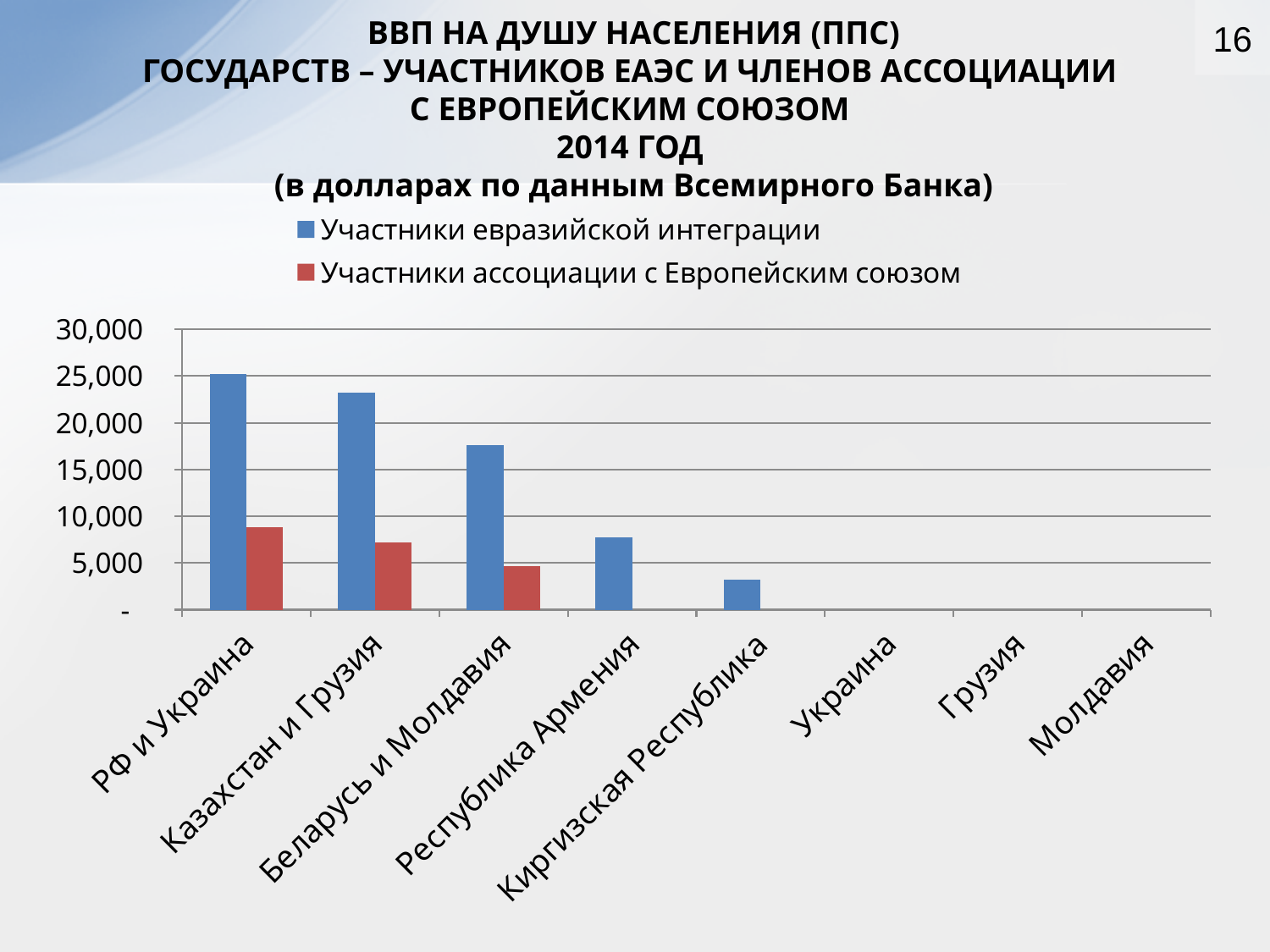
What kind of chart is shown on the slide? bar chart Which is larger in the category 'РФ и Украина': the value for 'Участники евразийской интеграции' or for 'Участники ассоциации с Европейским союзом'? Участники евразийской интеграции Which category has the highest value for the series 'Участники евразийской интеграции'? РФ и Украина Is the value for 'Участники евразийской интеграции' in the category 'Республика Армения' greater or less than 10,000? less How many categories are shown on the x axis? 8 Among the categories with a visible bar for 'Участники евразийской интеграции', which has the lowest value? Киргизская Республика Which colour represents the series 'Участники ассоциации с Европейским союзом' in the legend? red How many series does the legend list? 2 Is the value for 'Участники евразийской интеграции' in the category 'Казахстан и Грузия' greater or less than 20,000? greater Do the values for 'Участники евразийской интеграции' rise or fall from 'РФ и Украина' to 'Киргизская Республика' along the x axis? fall